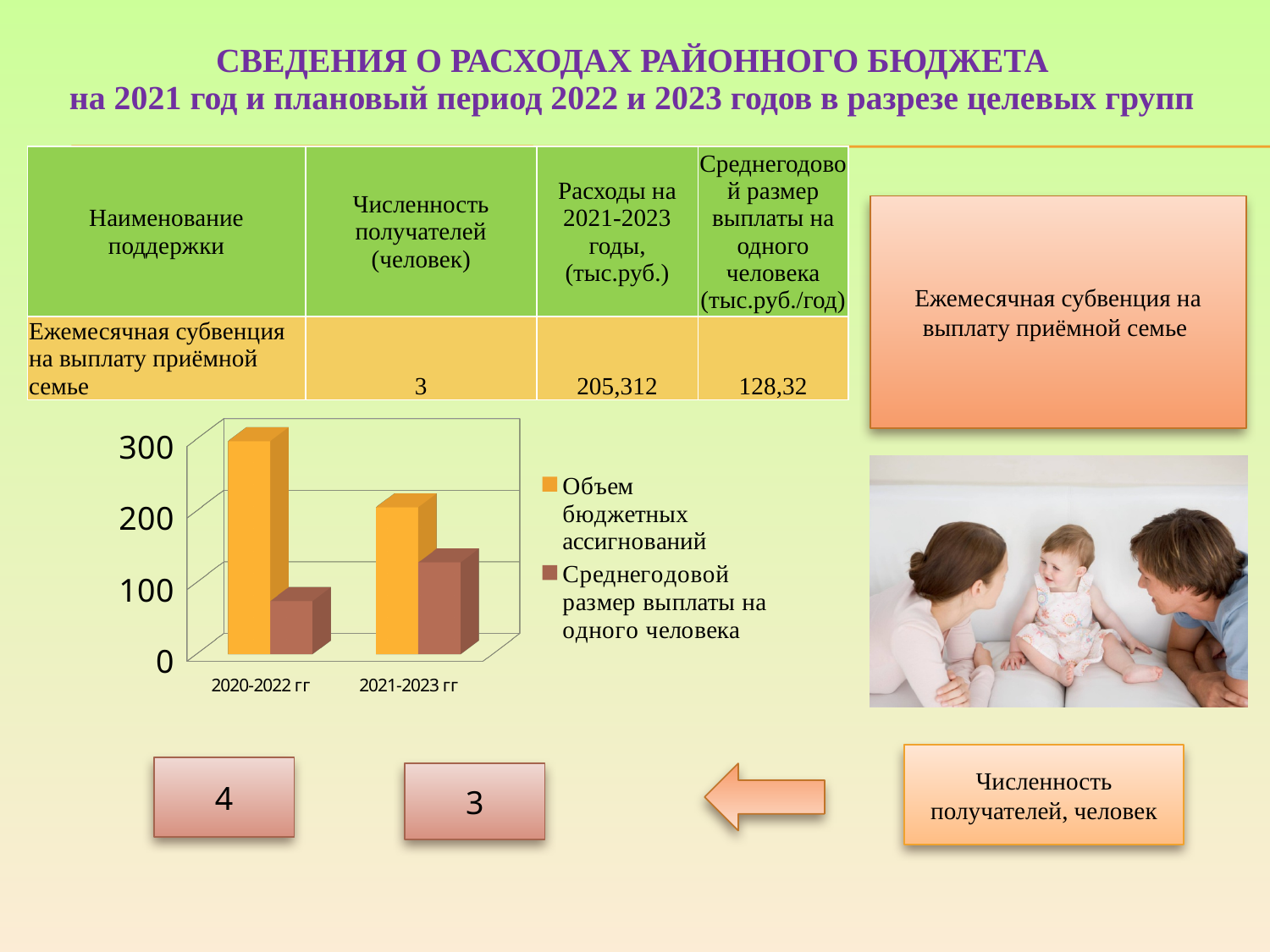
Is the value for Объем бюджетных ассигнований in 2021-2023 гг greater or less than 300? less How many categories are shown on the x axis of the chart? 2 Which category has the lowest bar for Среднегодовой размер выплаты на одного человека? 2020-2022 гг Does Объем бюджетных ассигнований rise or fall from 2020-2022 гг to 2021-2023 гг? fall Is the value for Объем бюджетных ассигнований in 2020-2022 гг greater or less than 200? greater How many series does the chart legend list? 2 Is the value for Среднегодовой размер выплаты на одного человека in 2021-2023 гг greater or less than 200? less Does Среднегодовой размер выплаты на одного человека rise or fall from 2020-2022 гг to 2021-2023 гг? rise In 2021-2023 гг, which is larger: Объем бюджетных ассигнований or Среднегодовой размер выплаты на одного человека? Объем бюджетных ассигнований Which category has the highest bar for Объем бюджетных ассигнований? 2020-2022 гг What kind of chart is shown on the slide? bar chart